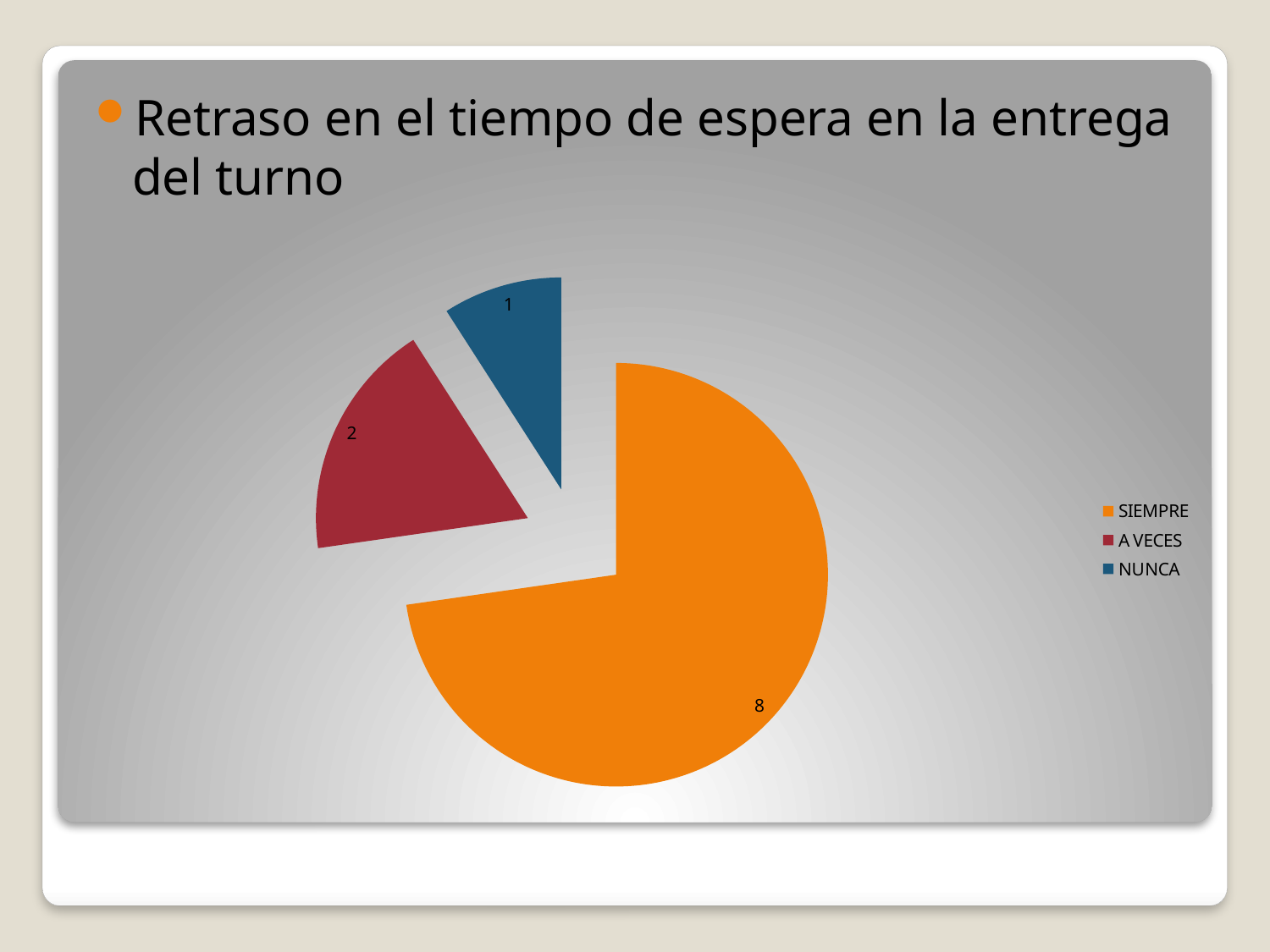
Which category has the smallest slice? NUNCA What is the value for A VECES? 2 What is the value for NUNCA? 1 What is the difference between the values for SIEMPRE and A VECES? 6 How many categories does the pie chart have? 3 Which is larger, the value for A VECES or the value for NUNCA? A VECES Which category has the largest slice? SIEMPRE Which legend entry is shown in blue? NUNCA What kind of chart is shown on the slide? pie chart What is the total of all slices in the pie chart? 11 What colour is the SIEMPRE slice? orange What is the value for SIEMPRE? 8